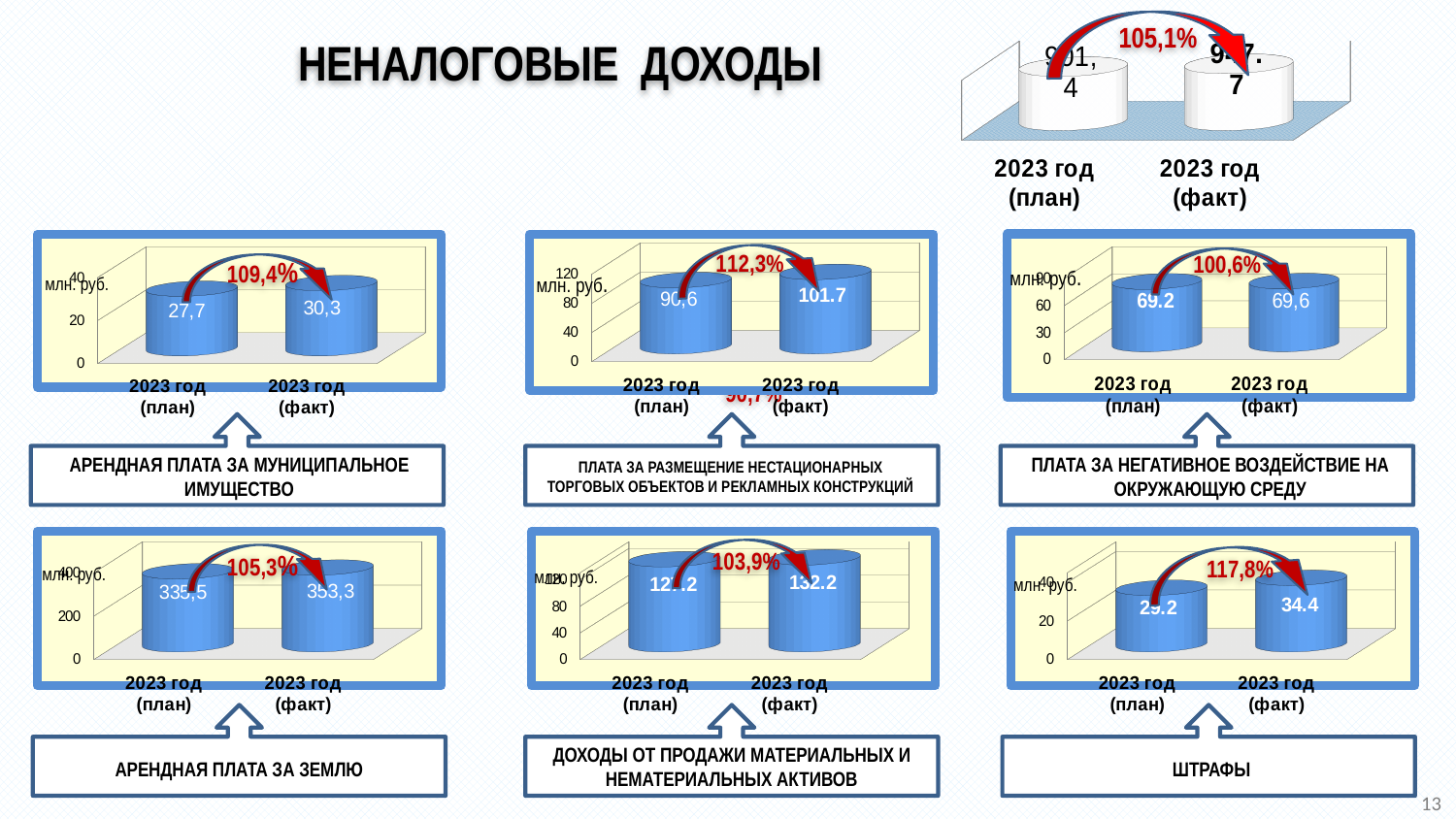
In the chart for ШТРАФЫ, which is larger, 2023 год (план) or 2023 год (факт)? 2023 год (факт) In the chart for ПЛАТА ЗА НЕГАТИВНОЕ ВОЗДЕЙСТВИЕ НА ОКРУЖАЮЩУЮ СРЕДУ, what is the value for 2023 год (план)? 69.2 What kind of chart is used for АРЕНДНАЯ ПЛАТА ЗА МУНИЦИПАЛЬНОЕ ИМУЩЕСТВО? bar chart In the chart for ПЛАТА ЗА РАЗМЕЩЕНИЕ НЕСТАЦИОНАРНЫХ ТОРГОВЫХ ОБЪЕКТОВ И РЕКЛАМНЫХ КОНСТРУКЦИЙ, what is the value for 2023 год (факт)? 101.7 In the chart for ДОХОДЫ ОТ ПРОДАЖИ МАТЕРИАЛЬНЫХ И НЕМАТЕРИАЛЬНЫХ АКТИВОВ, what is the value for 2023 год (факт)? 132.2 How many categories does the chart for АРЕНДНАЯ ПЛАТА ЗА ЗЕМЛЮ show? 2 In the chart for АРЕНДНАЯ ПЛАТА ЗА МУНИЦИПАЛЬНОЕ ИМУЩЕСТВО, what is the value for 2023 год (план)? 27,7 What percentage is shown above the chart for ШТРАФЫ? 117,8% In the chart for АРЕНДНАЯ ПЛАТА ЗА ЗЕМЛЮ, what is the value for 2023 год (факт)? 353,3 In the chart for ШТРАФЫ, what is the value for 2023 год (план)? 29.2 In the chart for АРЕНДНАЯ ПЛАТА ЗА ЗЕМЛЮ, what is the difference between the 2023 год (факт) and 2023 год (план) values? 17,8 In the chart for АРЕНДНАЯ ПЛАТА ЗА МУНИЦИПАЛЬНОЕ ИМУЩЕСТВО, what is the value for 2023 год (факт)? 30,3